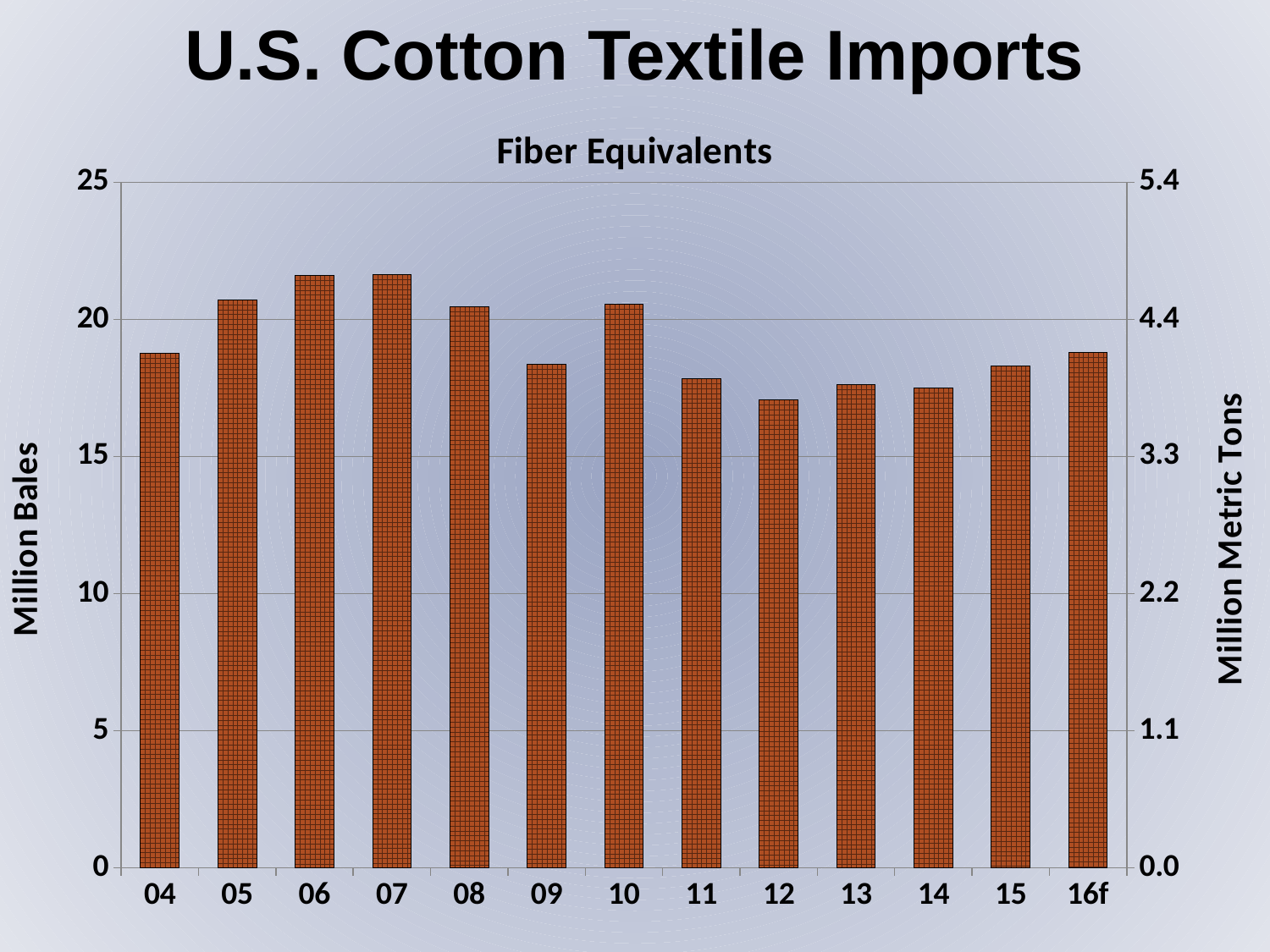
What kind of chart is shown on the slide? bar chart Is the value for 12 greater or less than 20 million bales? less What is the label of the right vertical axis? Million Metric Tons Which is larger, the value for 08 or the value for 14? 08 Is the value for 06 greater or less than 20 million bales? greater What is the label of the left vertical axis? Million Bales Which year has the lowest value for U.S. cotton textile imports? 12 Is the value for 04 greater or less than 15 million bales? greater Do the values rise or fall from 07 to 09? fall How many years (categories) are shown on the x axis? 13 Which is larger, the value for 05 or the value for 12? 05